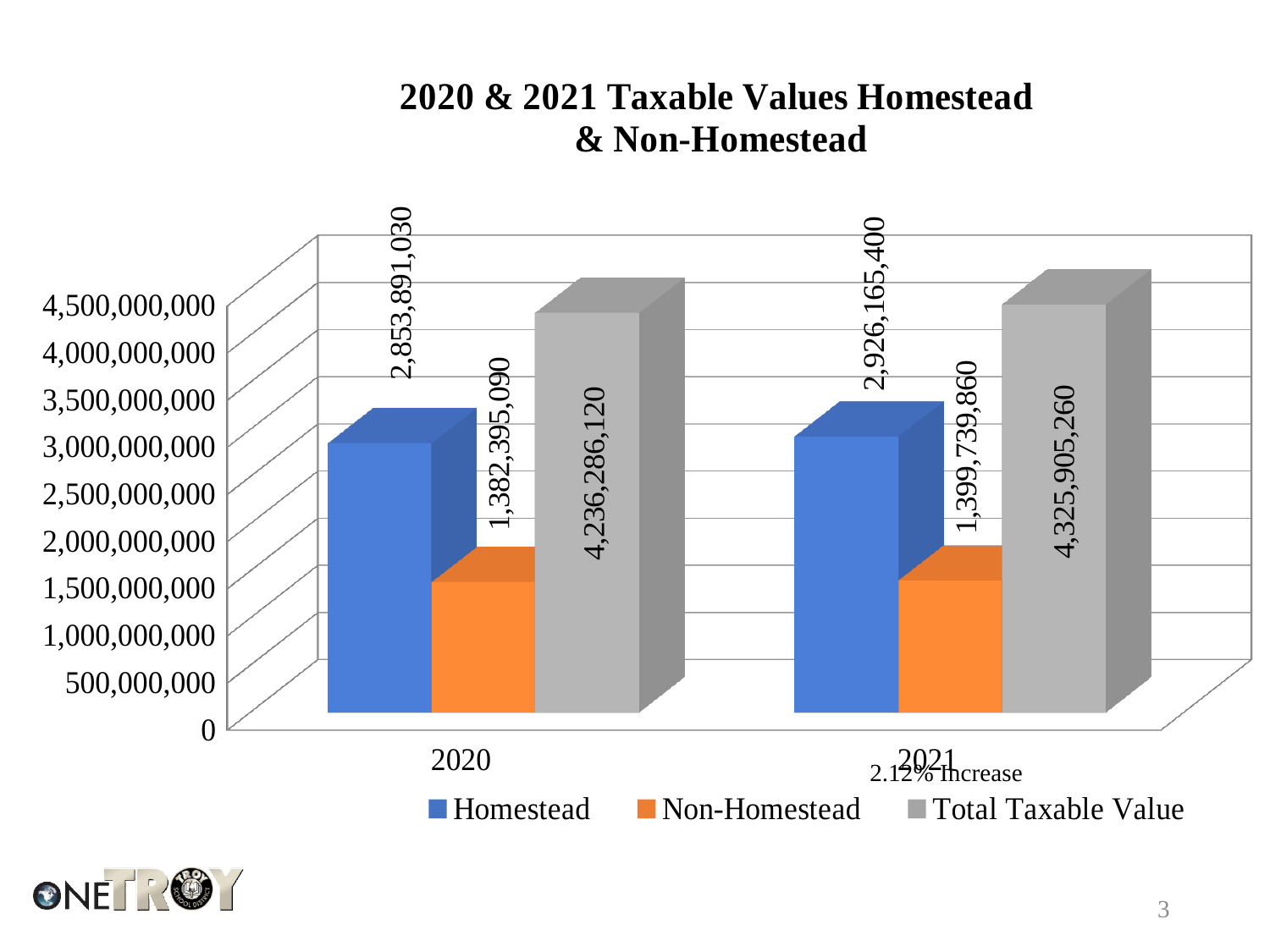
What is the Non-Homestead taxable value for 2021? 1,399,739,860 Is the Non-Homestead value for 2020 larger or smaller than the Homestead value for 2020? smaller What is the difference between the Total Taxable Value in 2021 and in 2020? 89,619,140 How many series does the legend list? 3 Which year has the higher Total Taxable Value? 2021 What is the Total Taxable Value for 2020? 4,236,286,120 What is the Homestead taxable value for 2020? 2,853,891,030 What kind of chart is shown on the slide? bar chart What is the Total Taxable Value for 2021? 4,325,905,260 What percentage increase is noted under the 2021 category? 2.12% increase Which series has the lowest value in 2020? Non-Homestead By how much did the Homestead taxable value increase from 2020 to 2021? 72,274,370